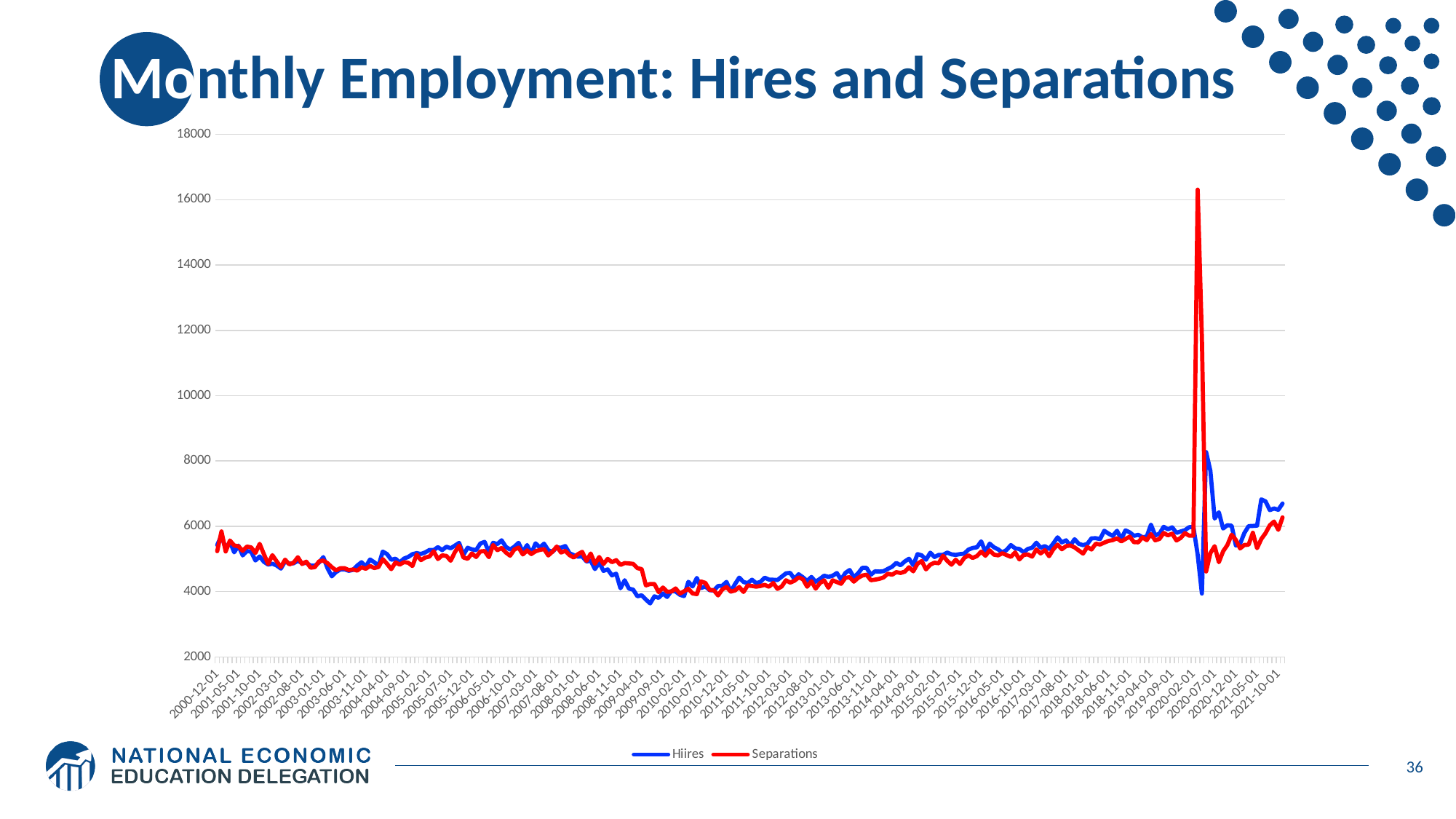
How many series does the legend list? 2 Do the Hiires values rise or fall between 2008-01-01 and 2009-04-01? fall Is the value for Hiires at 2000-12-01 greater or less than 4000? greater Is the peak value of the Separations series in 2020 greater or less than 14000? greater Which series reaches the highest value on the chart? Separations Do the Hiires values rise or fall between 2010-07-01 and 2019-09-01? rise What colour is the Separations line? red Around 2020-04-01, which series has the larger value, Hiires or Separations? Separations Is the lowest value of the Hiires series in 2020 greater or less than 6000? less What are the two series named in the legend? Hiires and Separations What kind of chart is shown on the slide? line chart